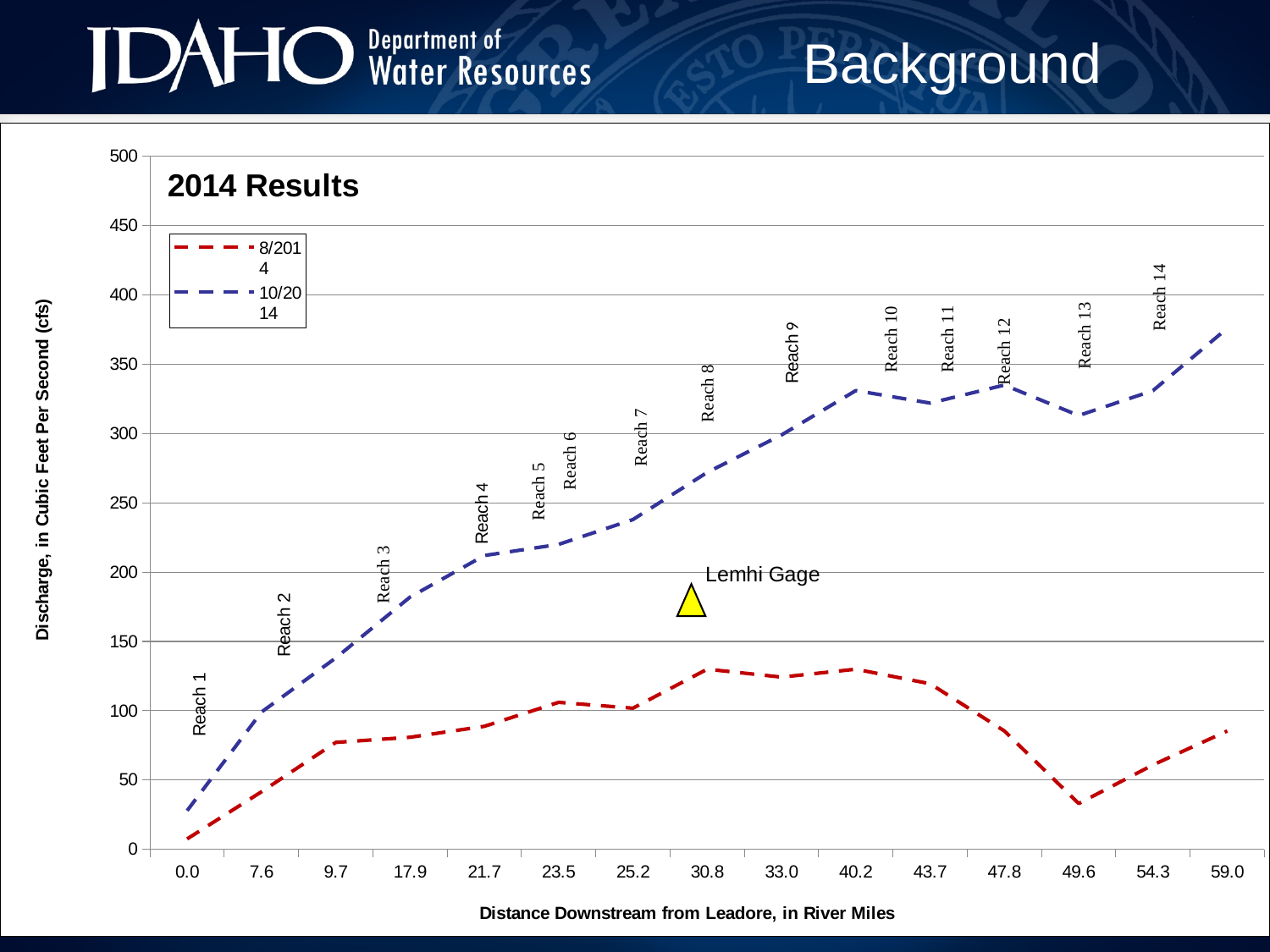
What is the title shown on the chart? 2014 Results What are the two series named in the chart legend? 8/2014 and 10/2014 Is the 10/2014 value at 59.0 river miles greater or less than 350? greater What kind of chart is shown on the slide? line chart At which distance downstream is the 10/2014 discharge highest? 59.0 Does the 10/2014 discharge rise or fall between 0.0 and 40.2 river miles? rise Is the 8/2014 value at 30.8 river miles greater or less than 100? greater Is the 10/2014 value at 7.6 river miles greater or less than 150? less At 40.2 river miles, which series has the higher discharge, 8/2014 or 10/2014? 10/2014 How many series does the chart legend list? 2 How many distance values are labelled along the x axis of the chart? 15